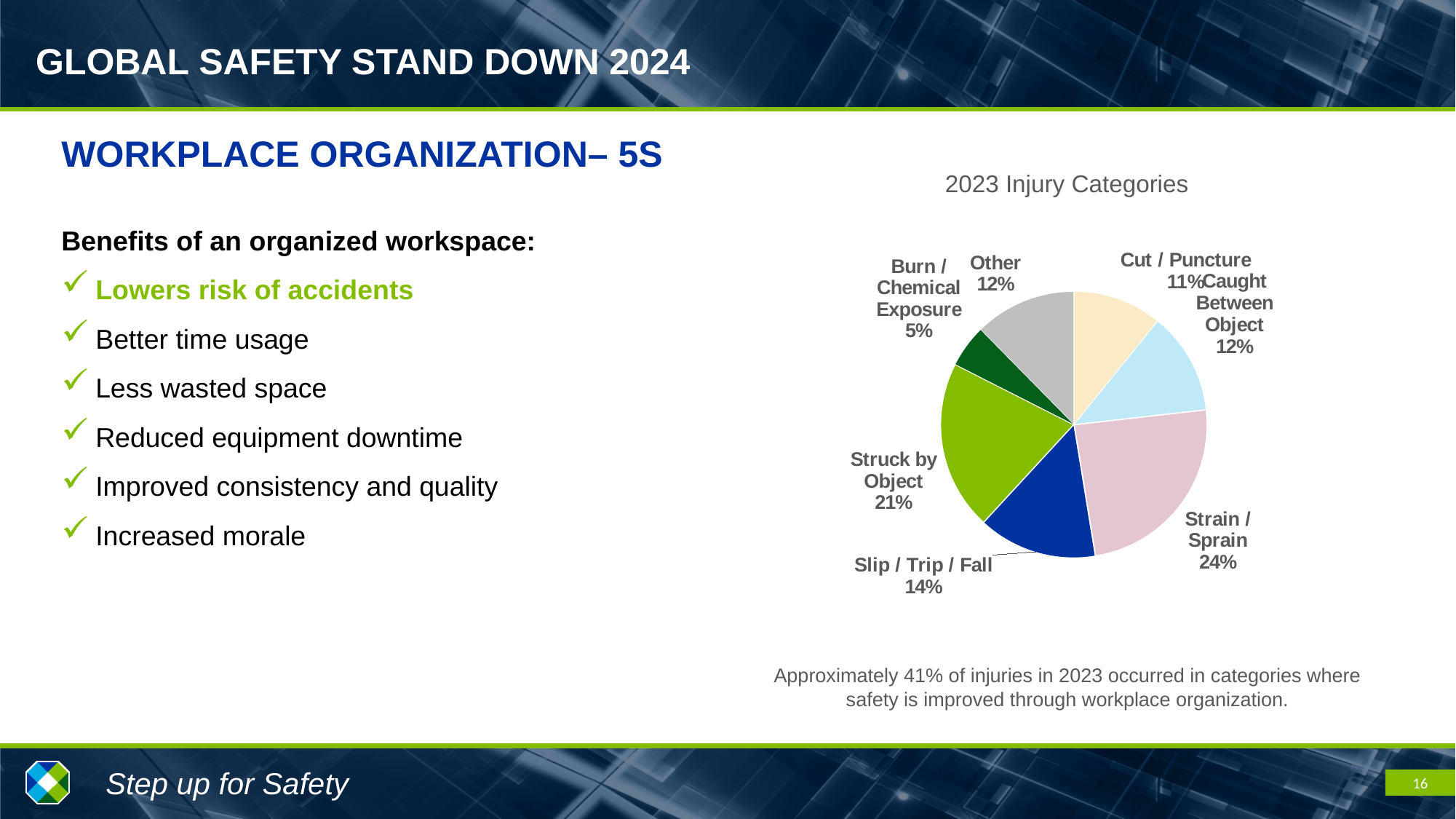
Which is larger, the share for Caught Between Object or the share for Burn / Chemical Exposure? Caught Between Object What share of injuries is attributed to Strain / Sprain? 24% What share of injuries is attributed to Slip / Trip / Fall? 14% Which injury category has the smallest share? Burn / Chemical Exposure What type of chart is shown on the slide? Pie chart What is the difference in percentage points between Strain / Sprain and Slip / Trip / Fall? 10 How many injury categories are shown in the pie chart? 7 What share of injuries is attributed to Burn / Chemical Exposure? 5% Which injury category has the largest share? Strain / Sprain What share of injuries is attributed to Cut / Puncture? 11% What is the title of the chart? 2023 Injury Categories What share of injuries is attributed to Struck by Object? 21%